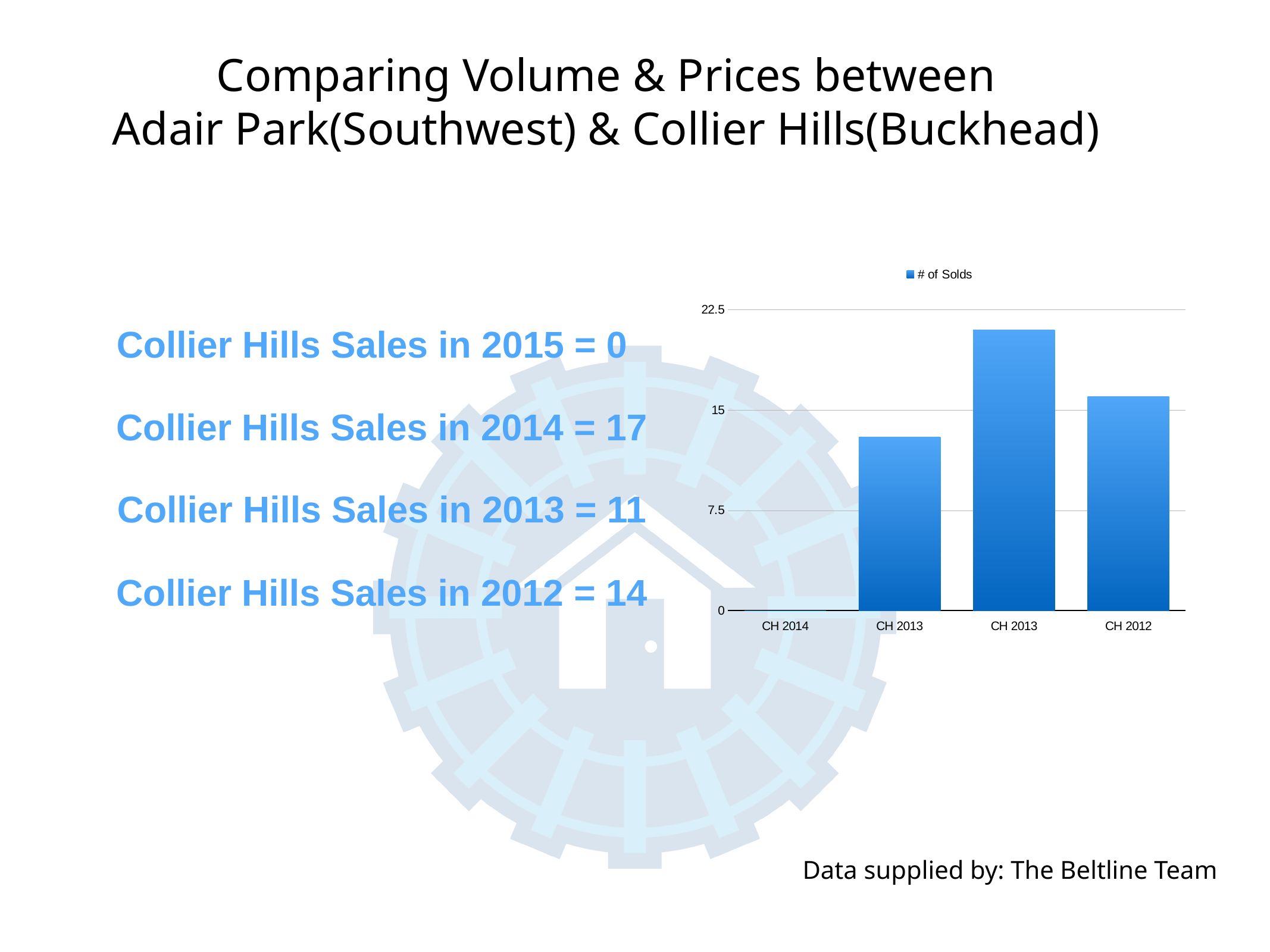
How many bars (categories) are plotted in the chart? 4 How many series does the chart's legend list? 1 Which is larger, the third bar from the left (CH 2013) or the fourth bar (CH 2012)? the third bar (CH 2013) Which is larger, the value for CH 2012 or the value for CH 2014? CH 2012 Which bar in the chart is the tallest? the third bar (CH 2013) Is the value of the second bar from the left (CH 2013) greater or less than 15? less What kind of chart is shown on the slide? bar chart What is the name of the series shown in the chart's legend? # of Solds Is the value of the third bar from the left (CH 2013) greater or less than 22.5? less What is the highest value labelled on the chart's vertical axis? 22.5 Is the value for CH 2012 greater or less than 15? greater Which category in the chart has the lowest value? CH 2014